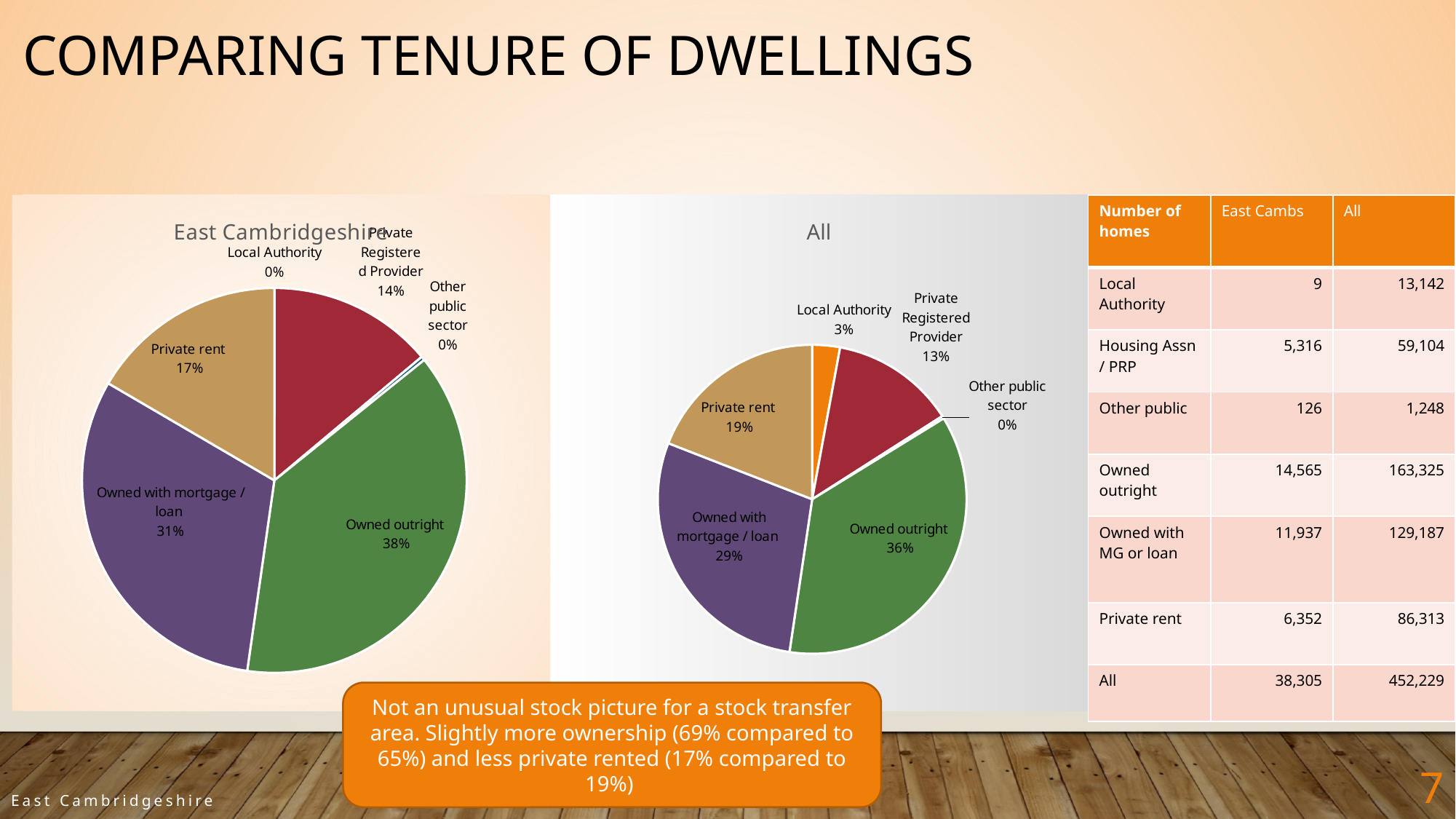
In the All pie chart, what share of dwellings is Private rent? 19% What is the title of the left-hand pie chart? East Cambridgeshire In the All pie chart, which category has the largest share? Owned outright In the East Cambridgeshire pie chart, what share of dwellings is Owned outright? 38% In the East Cambridgeshire pie chart, which category has the largest share? Owned outright In the All pie chart, what share is Local Authority? 3% In the All pie chart, which is larger: Owned with mortgage / loan or Private Registered Provider? Owned with mortgage / loan What type of chart is used for the All chart? Pie chart In the East Cambridgeshire pie chart, what is the difference between the Owned outright share and the Private rent share? 21% In the All pie chart, what share is Private Registered Provider? 13% In the East Cambridgeshire pie chart, what share is Owned with mortgage / loan? 31% How many categories are labelled in the East Cambridgeshire pie chart? 6